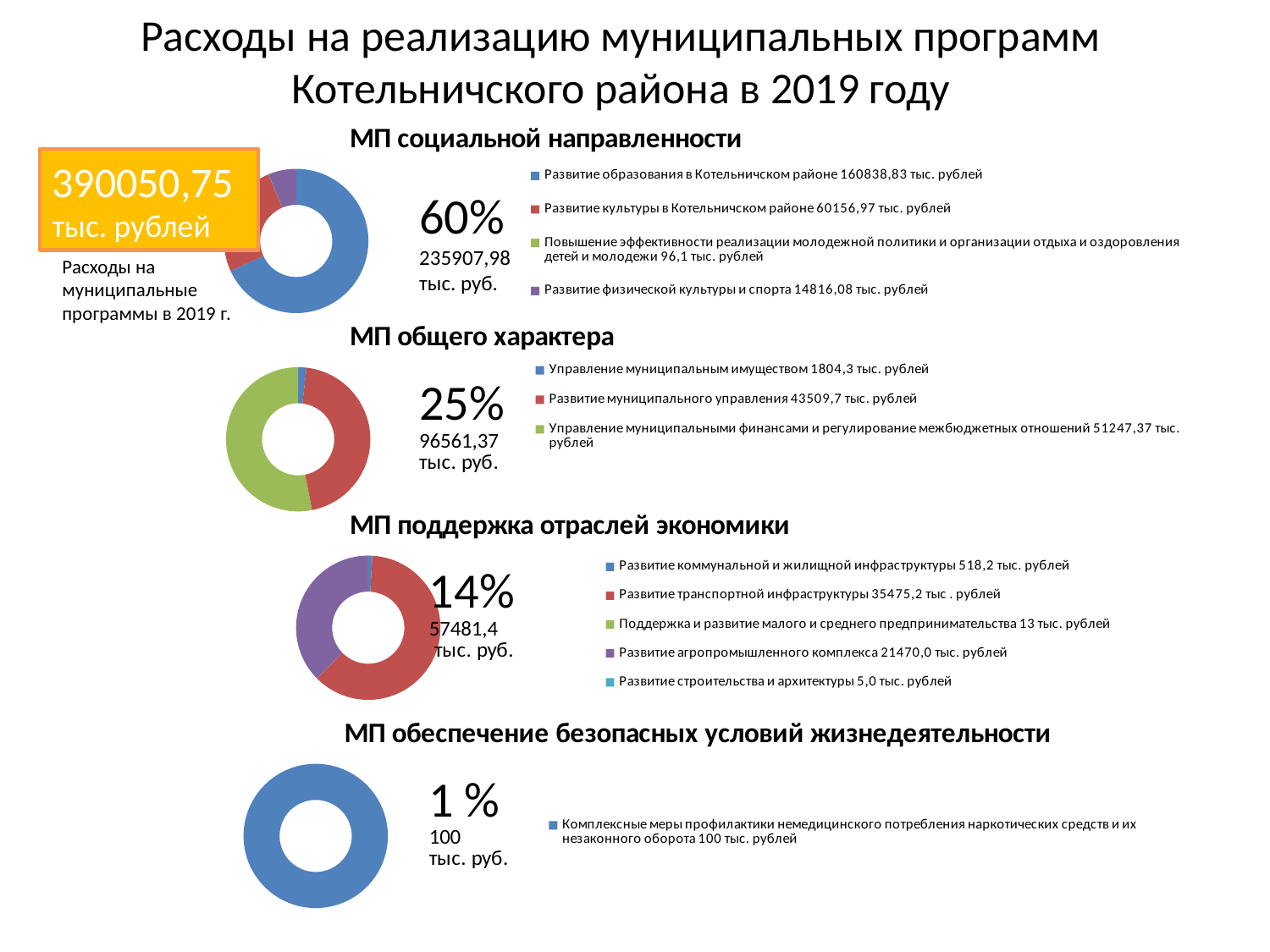
What kind of chart is used for 'МП обеспечение безопасных условий жизнедеятельности'? Doughnut chart On the chart 'МП социальной направленности', how many categories does the legend list? 4 On the chart 'МП поддержка отраслей экономики', what is the value for 'Развитие агропромышленного комплекса'? 21470,0 тыс. рублей On the chart 'МП поддержка отраслей экономики', how many categories does the legend list? 5 On the chart 'МП общего характера', what is the value for 'Развитие муниципального управления'? 43509,7 тыс. рублей On the chart 'МП социальной направленности', which category has the smallest value? Повышение эффективности реализации молодежной политики и организации отдыха и оздоровления детей и молодежи On the chart 'МП социальной направленности', what is the value for 'Развитие образования в Котельничском районе'? 160838,83 тыс. рублей What share of total expenditure is shown next to the chart 'МП социальной направленности'? 60% On the chart 'МП общего характера', which category has the largest value? Управление муниципальными финансами и регулирование межбюджетных отношений On the chart 'МП поддержка отраслей экономики', which is larger: 'Развитие транспортной инфраструктуры' or 'Развитие агропромышленного комплекса'? Развитие транспортной инфраструктуры On the chart 'МП общего характера', what is the total shown for the group? 96561,37 тыс. руб. On the chart 'МП поддержка отраслей экономики', what is the difference between 'Развитие транспортной инфраструктуры' and 'Развитие агропромышленного комплекса'? 14005,2 тыс. рублей